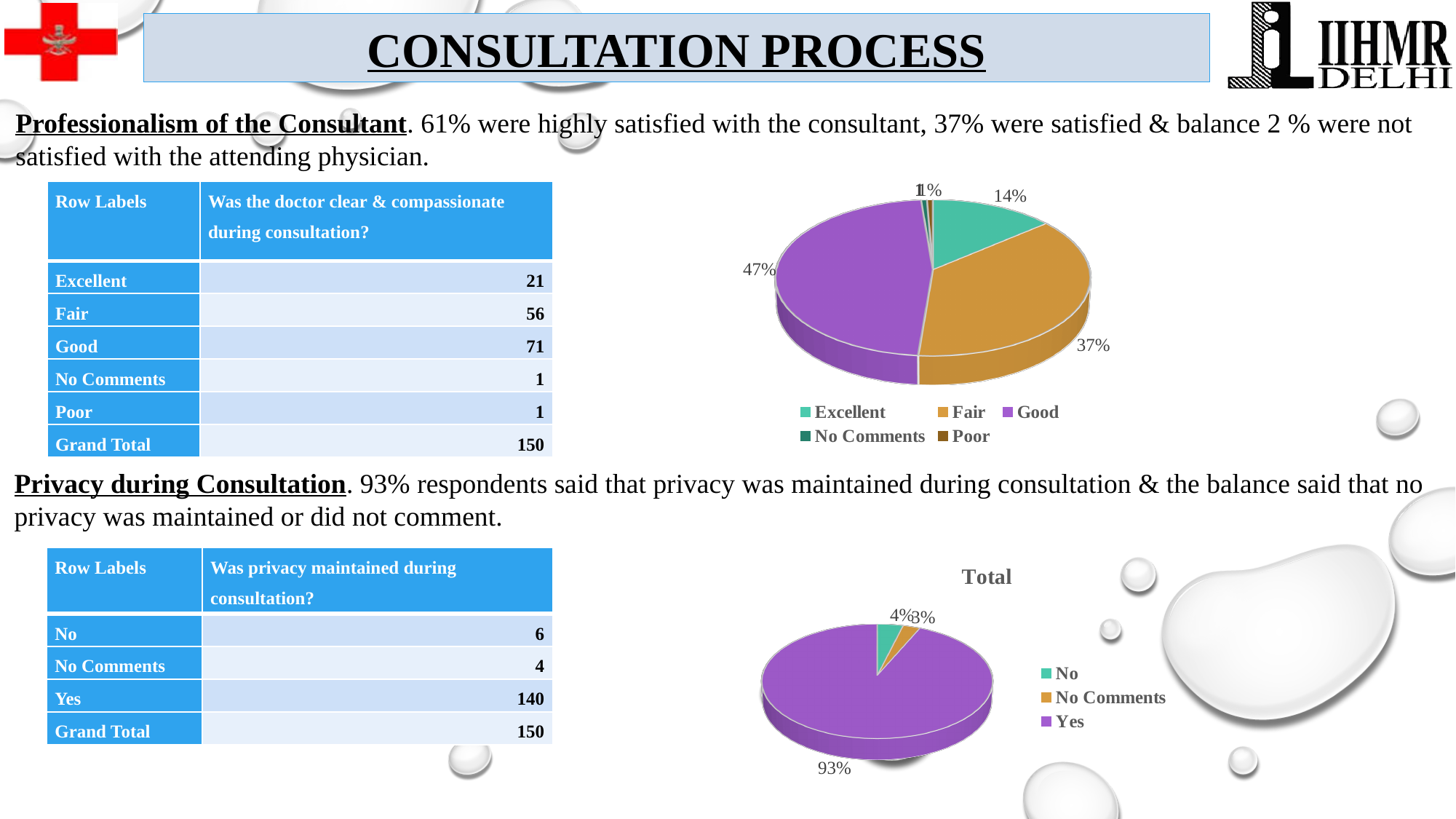
In the top pie chart (doctor clear & compassionate), how many categories does the legend list? 5 In the top pie chart (doctor clear & compassionate), what is the difference in percentage points between the Good and Fair slices? 10 In the top pie chart (doctor clear & compassionate), which category has the largest slice? Good In the top pie chart (doctor clear & compassionate), what share does the Good slice have? 47% In the top pie chart (doctor clear & compassionate), what share does the Fair slice have? 37% In the top pie chart (doctor clear & compassionate), which is larger, the Fair slice or the Excellent slice? Fair In the top pie chart (doctor clear & compassionate), what share does the Excellent slice have? 14% In the bottom pie chart titled 'Total', how many categories does the legend list? 3 In the bottom pie chart titled 'Total', which category has the smallest slice? No Comments What kind of chart is the bottom chart titled 'Total'? Pie chart